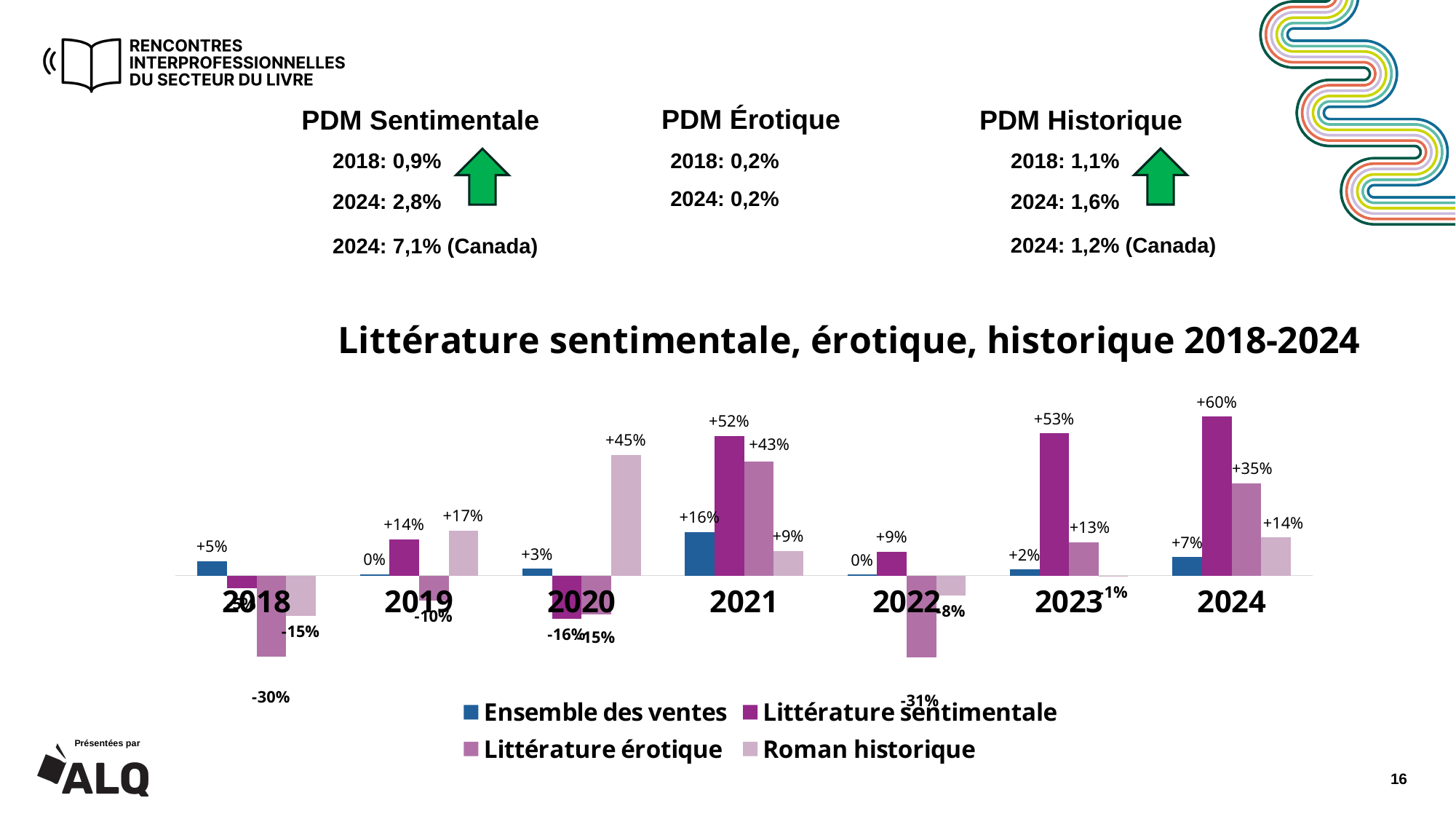
What is the value for Littérature sentimentale in 2024? +60% In which year is the value for Roman historique the highest? 2020 What is the value for Ensemble des ventes in 2021? +16% What kind of chart is shown on the slide? Bar chart What is the value for Roman historique in 2020? +45% In 2024, which is larger: Littérature sentimentale or Littérature érotique? Littérature sentimentale Does the value for Ensemble des ventes rise or fall from 2022 to 2024? Rise In 2021, what is the difference between the Littérature sentimentale value and the Littérature érotique value? 9 percentage points How many series does the legend list? 4 In which year is the value for Littérature sentimentale the highest? 2024 What is the value for Littérature érotique in 2022? -31% How many years are shown on the x axis of the chart? 7